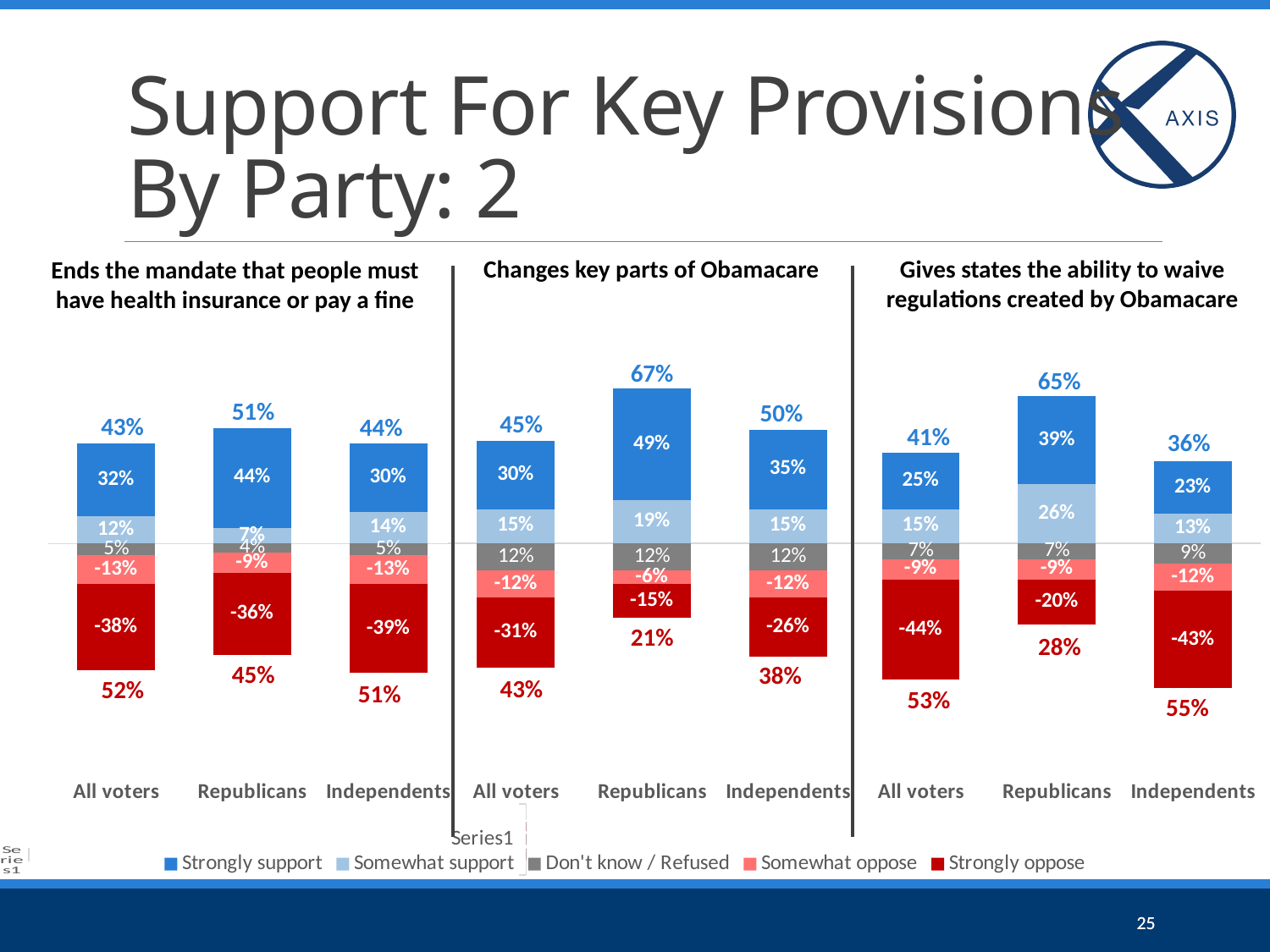
What kind of chart is used for "Ends the mandate that people must have health insurance or pay a fine"? Stacked bar chart In the chart titled "Changes key parts of Obamacare", what is the Strongly support value for Republicans? 49% Which legend entry is shown in dark red? Strongly oppose In the chart titled "Gives states the ability to waive regulations created by Obamacare", what is the Somewhat support value for Republicans? 26% How many groups (categories) are shown on the x axis of the chart titled "Gives states the ability to waive regulations created by Obamacare"? 3 In the chart titled "Changes key parts of Obamacare", which group has the highest total support percentage shown above the bars? Republicans In the chart titled "Ends the mandate that people must have health insurance or pay a fine", what is the difference between the Strongly support values for Republicans and Independents? 14% In the chart titled "Ends the mandate that people must have health insurance or pay a fine", what is the Strongly oppose value for Independents? -39% In the chart titled "Changes key parts of Obamacare", is the Strongly oppose value larger in magnitude for All voters or for Independents? All voters In the chart titled "Gives states the ability to waive regulations created by Obamacare", which group has the lowest total support percentage shown above the bars? Independents How many series does the legend at the bottom of the slide list? 5 In the chart titled "Changes key parts of Obamacare", what is the total oppose percentage shown below the bar for Republicans? 21%